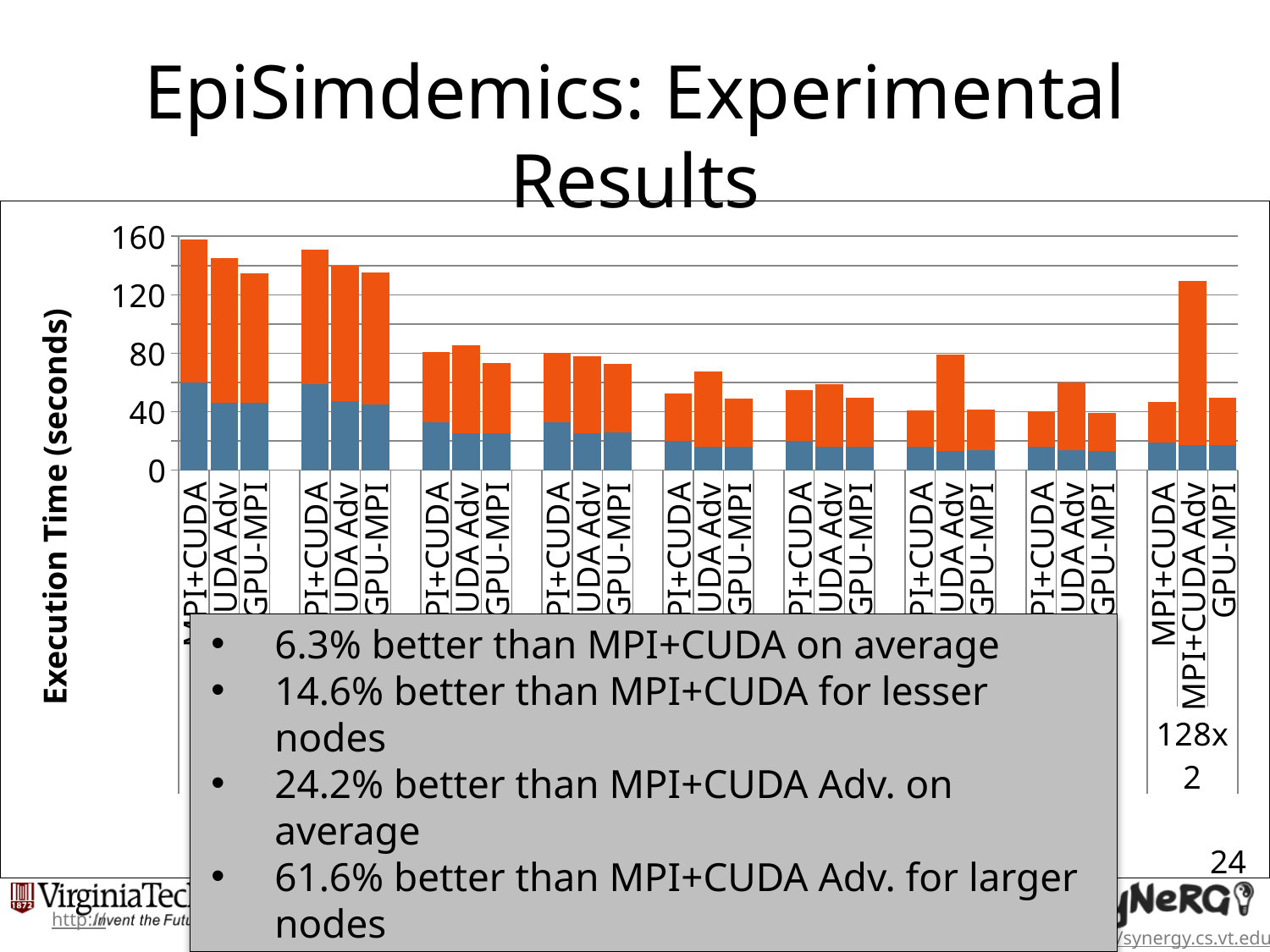
In the leftmost group, is the total execution time for MPI+CUDA greater or less than 120 seconds? greater What is the label on the vertical axis of the chart? Execution Time (seconds) In the 128x2 group, is the total execution time for MPI+CUDA Adv greater or less than 120 seconds? greater In the 128x2 group, which configuration has the tallest bar? MPI+CUDA Adv How many bars are in each group of the chart? 3 Moving from the leftmost group to the right, do the MPI+CUDA execution times generally rise or fall? fall What is the highest tick value shown on the vertical axis? 160 In the 128x2 group, is the total execution time for GPU-MPI greater or less than 80 seconds? less How many groups of bars are plotted in the chart? 9 In the 128x2 group, which has the larger total execution time: MPI+CUDA Adv or GPU-MPI? MPI+CUDA Adv What kind of chart is shown on the slide? stacked bar chart In the leftmost group, which has the larger total execution time: MPI+CUDA or GPU-MPI? MPI+CUDA